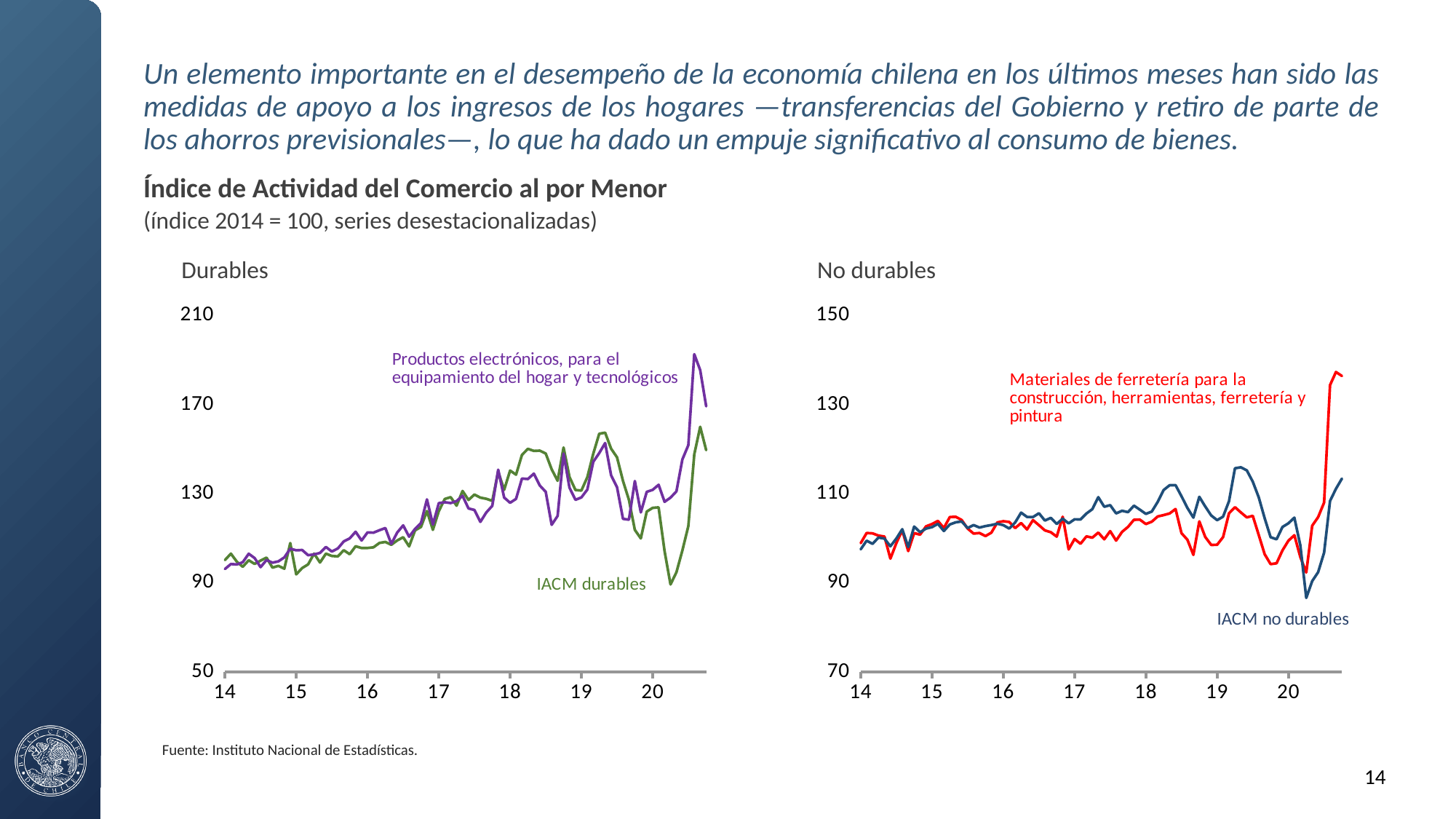
In the No durables chart, what colour is the IACM no durables line? blue In the No durables chart, is the value of IACM no durables at the end of the series greater or less than 100? greater What kind of chart is the Durables chart? line chart How many series are plotted in the No durables chart? 2 In the No durables chart, which series is higher at the end of the series: Materiales de ferretería or IACM no durables? Materiales de ferretería In the Durables chart, is the value of IACM durables at the start of 2014 greater or less than 130? less In the Durables chart, which series is higher at the end of the series: Productos electrónicos or IACM durables? Productos electrónicos In the Durables chart, is the peak value of the Productos electrónicos series in 2020 greater or less than 170? greater How many series are plotted in the Durables chart? 2 What is the title of the chart on the right side of the slide? No durables In the Durables chart, does the Productos electrónicos series overall rise or fall from 2014 to 2020? rise